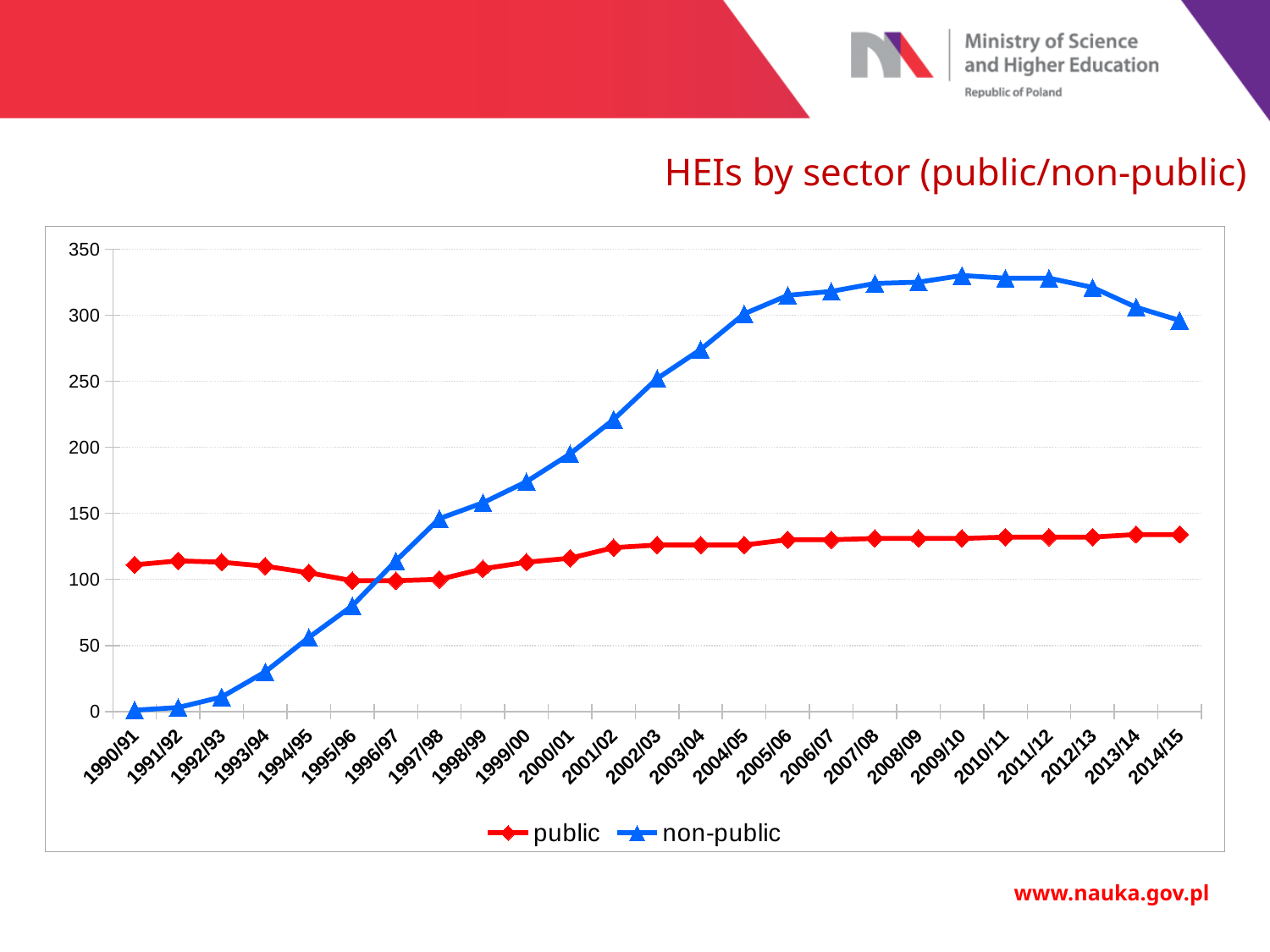
How many series does the legend list? 2 Is the value for non-public in 1993/94 greater or less than 50? less How many academic years are plotted along the x axis? 25 Which series is drawn with triangle markers? non-public In 2014/15, which series has the larger value, public or non-public? non-public In 1990/91, which series has the larger value, public or non-public? public In which year is the non-public series at its lowest? 1990/91 Is the value for public in 2014/15 greater or less than 150? less What is the title of the chart? HEIs by sector (public/non-public) Is the value for non-public in 2014/15 greater or less than 300? less What kind of chart is shown on the slide? line chart